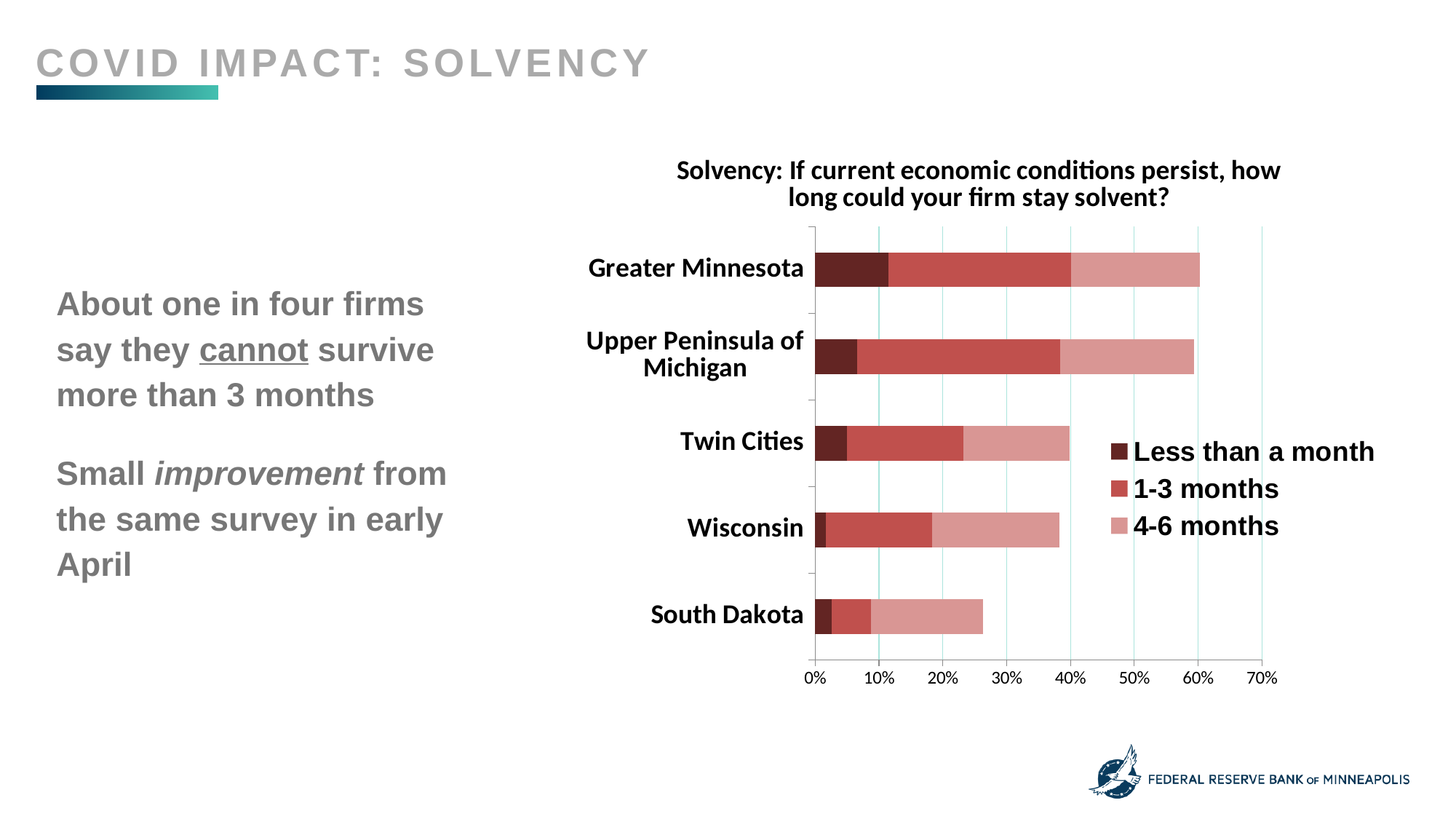
What kind of chart is shown on the slide? Stacked bar chart Which legend entry is shown in the darkest colour? Less than a month Which region has the larger 'Less than a month' segment, Greater Minnesota or Wisconsin? Greater Minnesota Is the total bar for South Dakota greater or less than 30%? less Is the total bar for Greater Minnesota greater or less than 50%? greater What is the title of the chart? Solvency: If current economic conditions persist, how long could your firm stay solvent? Which has the longer total bar, Twin Cities or South Dakota? Twin Cities Is the total bar for Twin Cities greater or less than 50%? less How many regions are listed on the chart's vertical axis? 5 How many series does the chart's legend list? 3 Which region has the shortest total bar on the chart? South Dakota